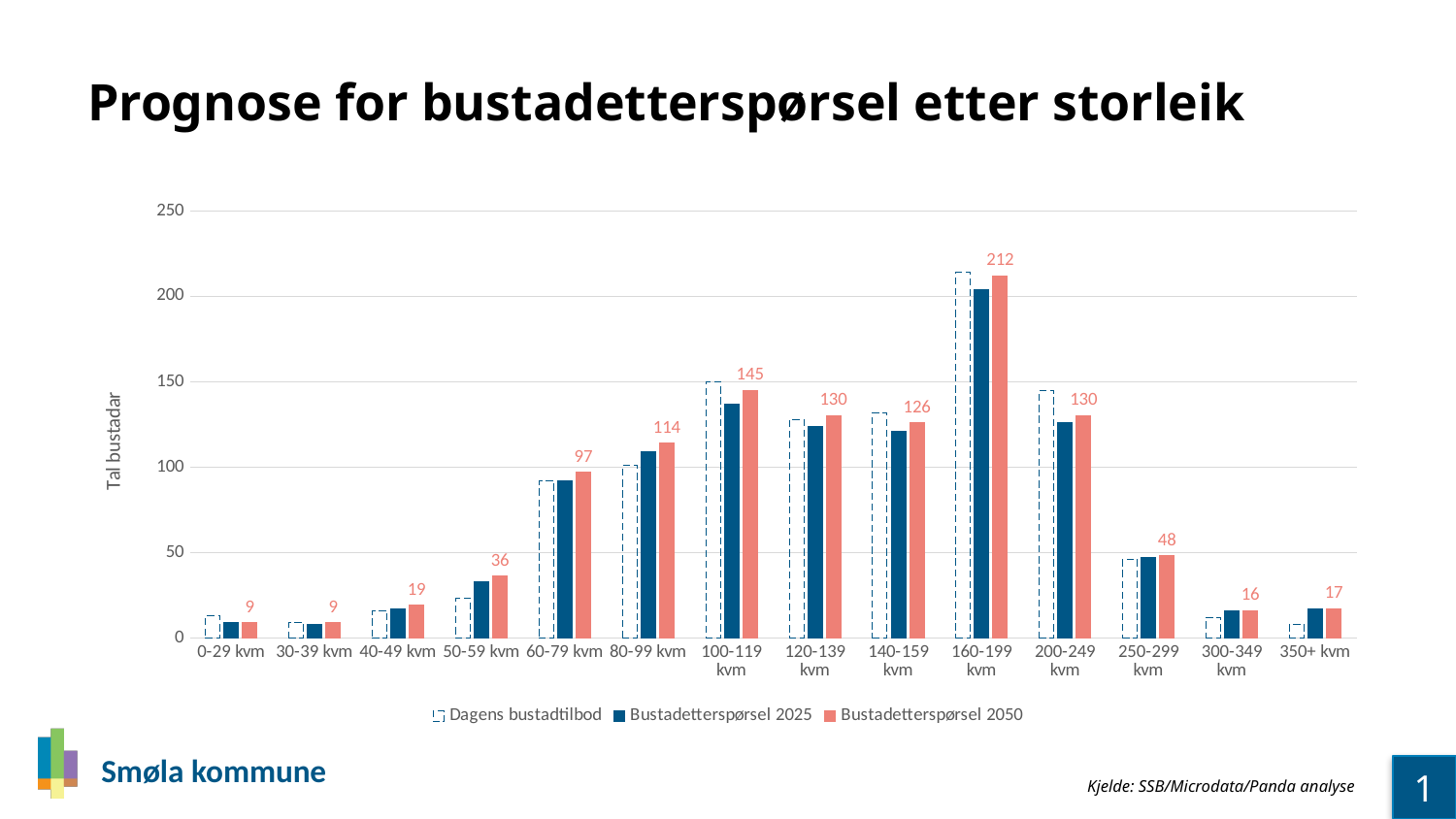
How many size categories are shown on the x axis? 14 Which has a larger Bustadetterspørsel 2050 value, 80-99 kvm or 60-79 kvm? 80-99 kvm What is the difference between the Bustadetterspørsel 2050 values for 160-199 kvm and 100-119 kvm? 67 How many series does the legend list? 3 What is the label on the vertical axis? Tal bustadar Is the Bustadetterspørsel 2025 value for 100-119 kvm greater or less than 150? less Is the Bustadetterspørsel 2025 value for 160-199 kvm greater or less than 200? greater What is the Bustadetterspørsel 2050 value for 100-119 kvm? 145 What is the Bustadetterspørsel 2050 value for 50-59 kvm? 36 Which size category has the highest Bustadetterspørsel 2050 value? 160-199 kvm What kind of chart is shown on the slide? Bar chart What is the Bustadetterspørsel 2050 value for 160-199 kvm? 212